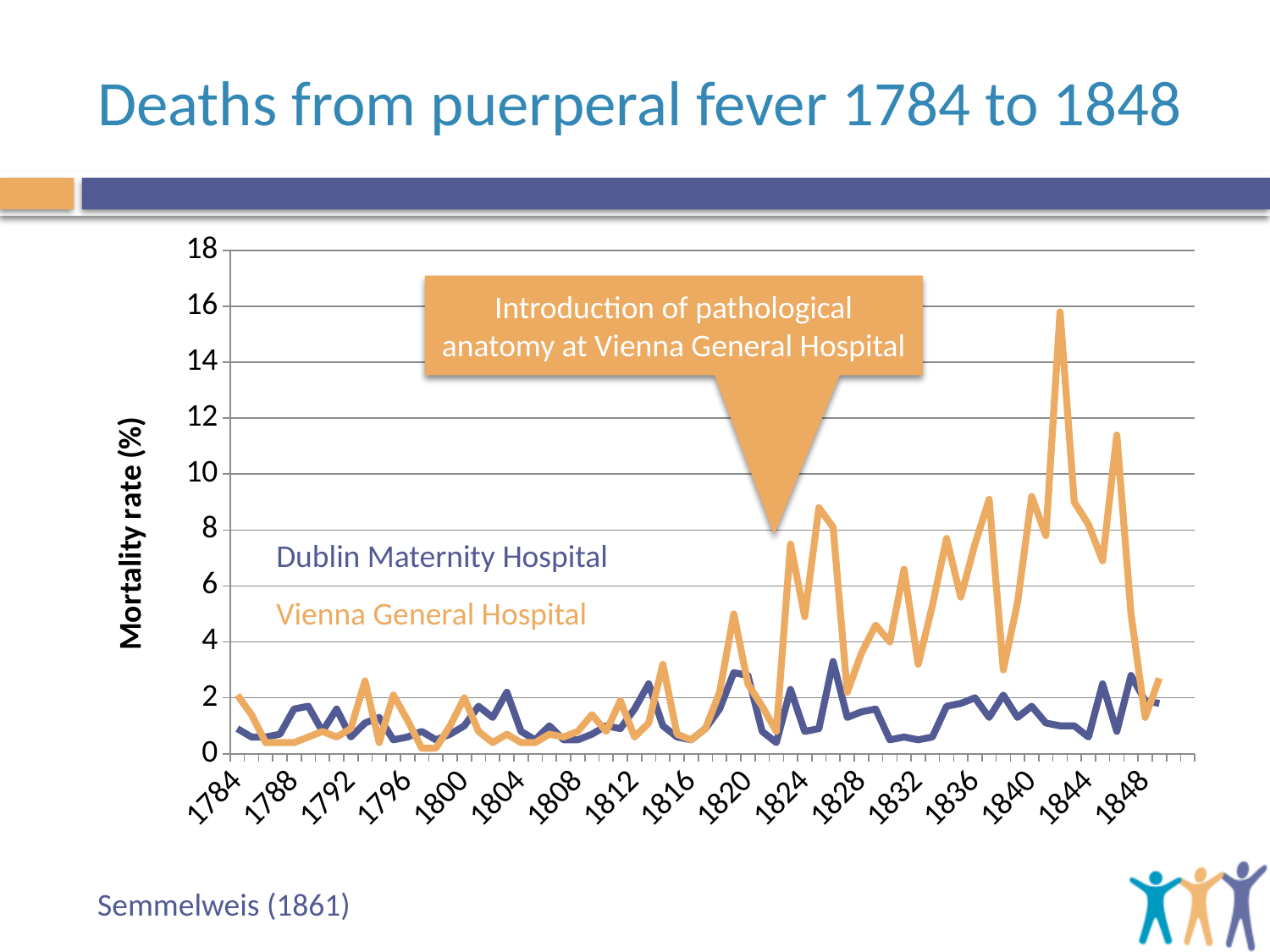
Does the mortality rate for Vienna General Hospital generally rise or fall between 1824 and 1844? rise Is the value for Dublin Maternity Hospital in 1784 greater or less than 2? less Is the value for Vienna General Hospital around 1846 greater or less than 10? greater Which series reaches the highest mortality rate on the chart? Vienna General Hospital Is the peak value for Vienna General Hospital around 1843 greater or less than 14? greater What is the title of the chart on the slide? Deaths from puerperal fever 1784 to 1848 What kind of chart is shown on the slide? Line chart Around 1843, which hospital has the higher mortality rate, Dublin Maternity Hospital or Vienna General Hospital? Vienna General Hospital How many data series are plotted on the chart? 2 What is the label of the vertical axis? Mortality rate (%) How many year labels are shown on the horizontal axis? 17